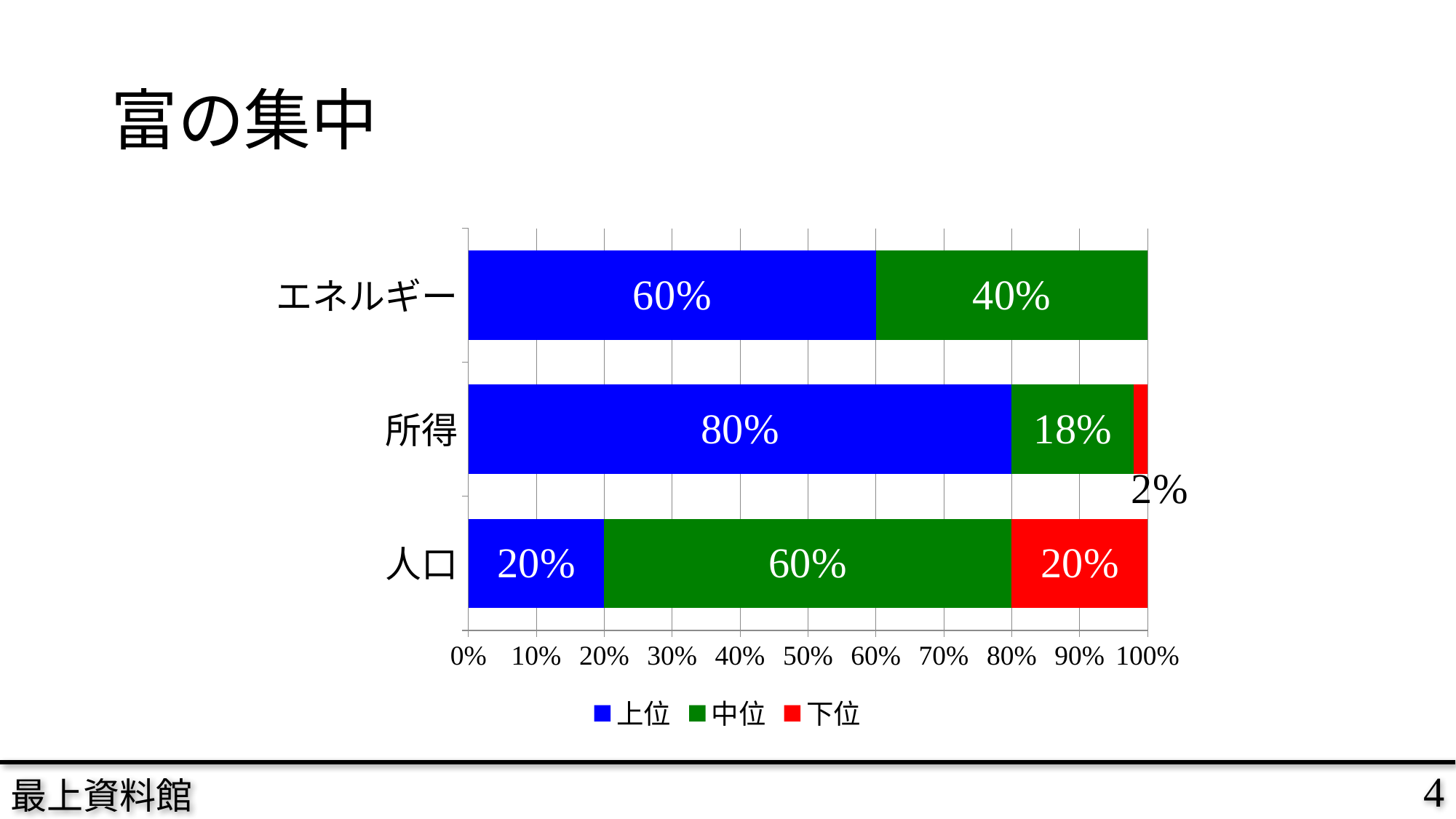
Which category has the lowest 上位 value? 人口 Which category has the highest 上位 value? 所得 What is the difference between the 上位 values for 所得 and 人口? 60% What is the value of 下位 for 所得? 2% How many series does the legend list? 3 How many categories are shown on the chart? 3 What is the value of 上位 for 所得? 80% What colour represents the 下位 series? Red What kind of chart is shown on the slide? Stacked bar chart Which is larger, the 中位 value for 所得 or the 中位 value for エネルギー? エネルギー What is the value of 中位 for エネルギー? 40% What is the value of 中位 for 人口? 60%